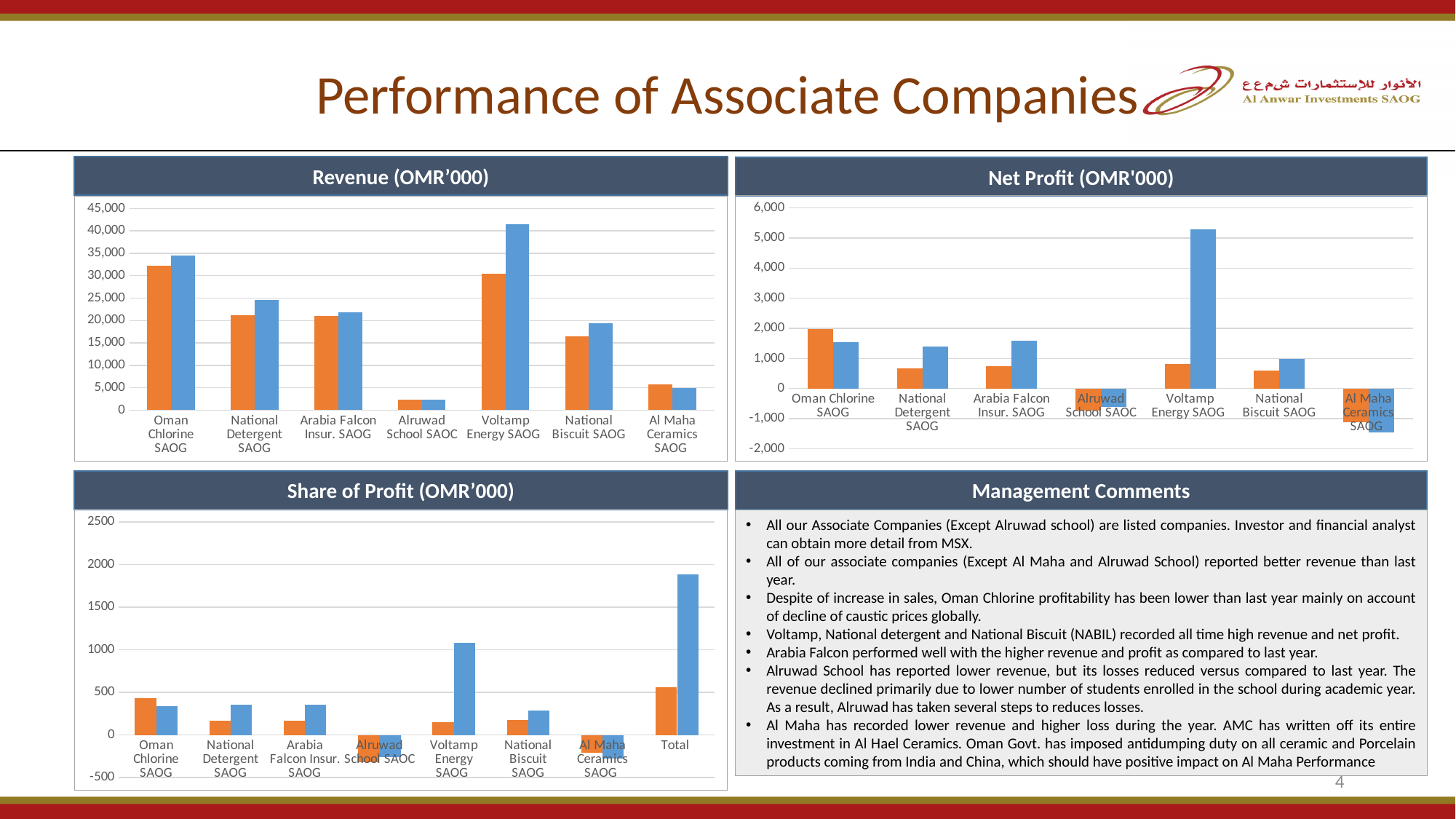
In the Revenue (OMR'000) chart, is the orange bar for Al Maha Ceramics SAOG greater or less than 10,000? less In the Net Profit (OMR'000) chart, is the blue bar for Al Maha Ceramics SAOG greater or less than -1,000? less In the Share of Profit (OMR'000) chart, is the blue bar for Total greater or less than 1500? greater In the Revenue (OMR'000) chart, which company has the lowest revenue bars? Alruwad School SAOC In the Revenue (OMR'000) chart, which has the larger blue bar: Oman Chlorine SAOG or National Detergent SAOG? Oman Chlorine SAOG In the Net Profit (OMR'000) chart, which company has the highest bar? Voltamp Energy SAOG How many categories are shown on the x axis of the Share of Profit (OMR'000) chart? 8 In the Revenue (OMR'000) chart, which company has the tallest bar? Voltamp Energy SAOG How many companies are shown on the x axis of the Revenue (OMR'000) chart? 7 What kind of chart is the Revenue (OMR'000) chart? bar chart